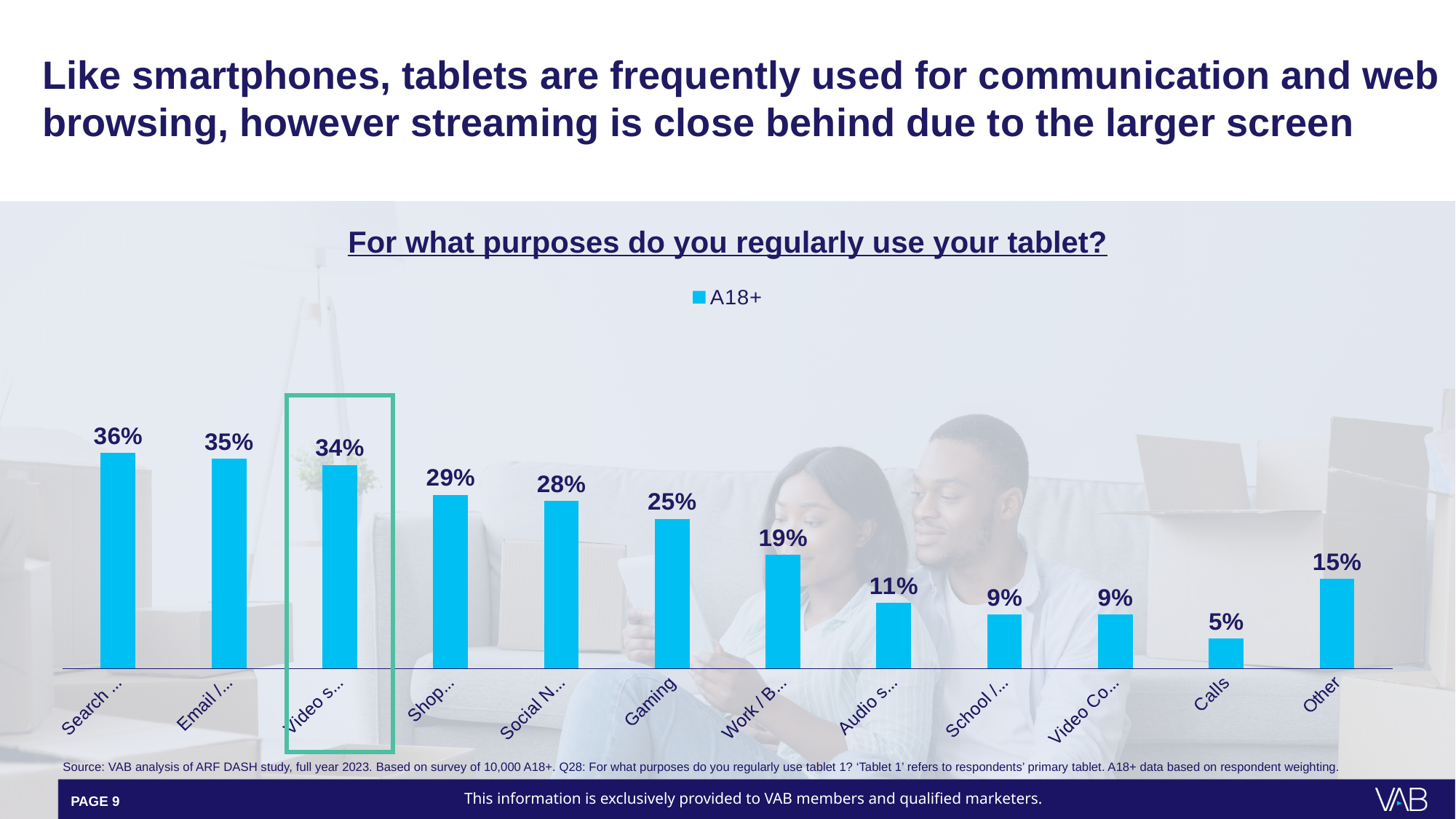
What is the value shown for Calls? 5% What percentage of respondents regularly use their tablet for Gaming? 25% What is the difference between the values for Gaming and Calls? 20 percentage points What kind of chart is shown on the slide? Bar chart What is the highest value shown on the chart? 36% Which category has the lowest value? Calls What is the value shown for Other? 15% How many categories are shown on the chart? 12 How many series does the legend list? 1 Which is larger, the value for Gaming or the value for Other? Gaming What is the value of the bar highlighted with the green box? 34% What is the difference between the values for Other and Calls? 10 percentage points